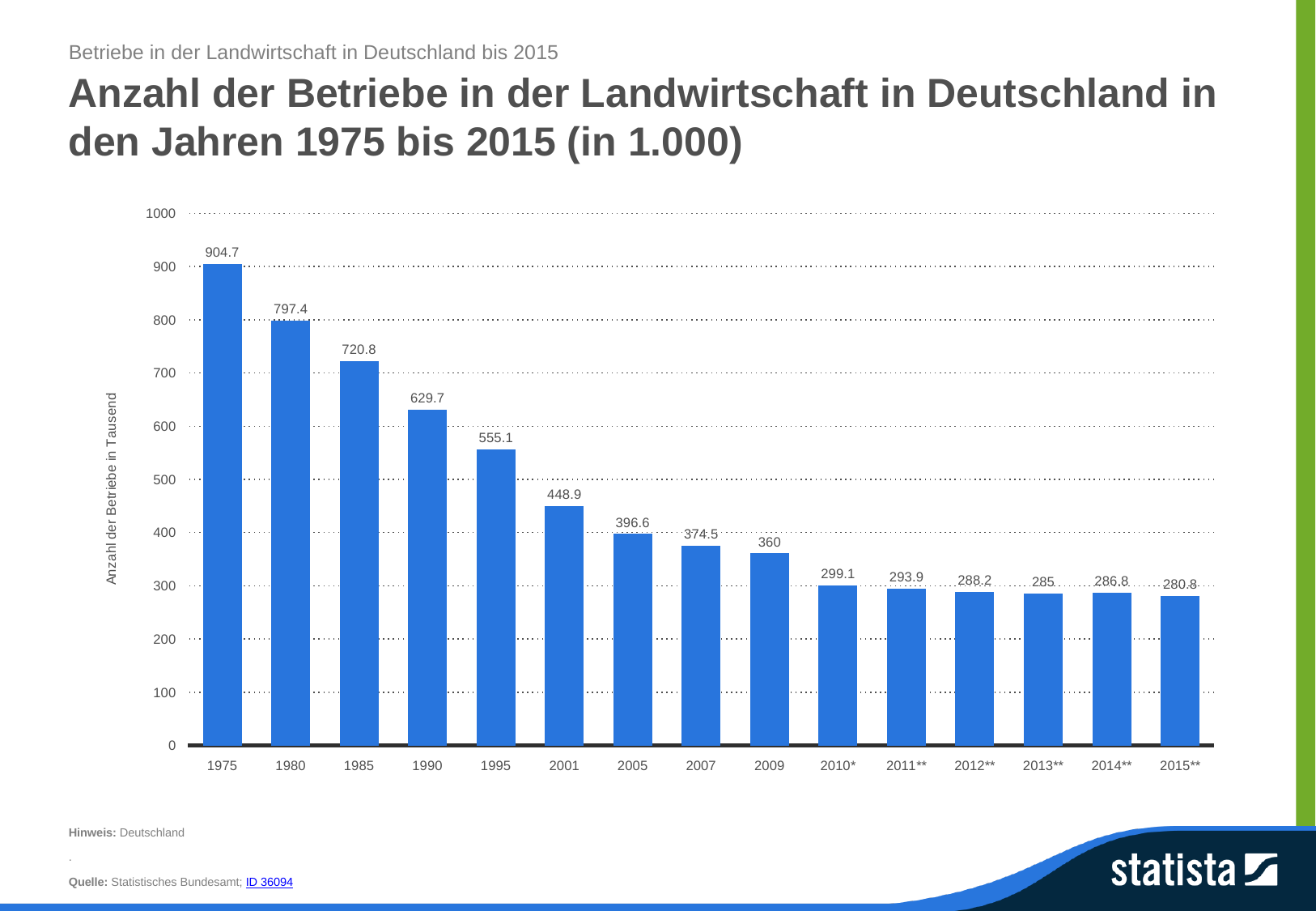
Which year has the highest value? 1975 What is the value for 2015**? 280.8 What is the value for 1975? 904.7 Is the value for 2007 greater or less than 400? less Which is larger, the value for 1990 or the value for 1995? 1990 What is the value for 2009? 360 What is the difference between the values for 2001 and 2005? 52.3 What is the difference between the values for 1975 and 1980? 107.3 Do the values generally rise or fall from 1975 to 2015? fall Which year has the lowest value? 2015** How many years are shown on the x axis? 15 What kind of chart is this? bar chart